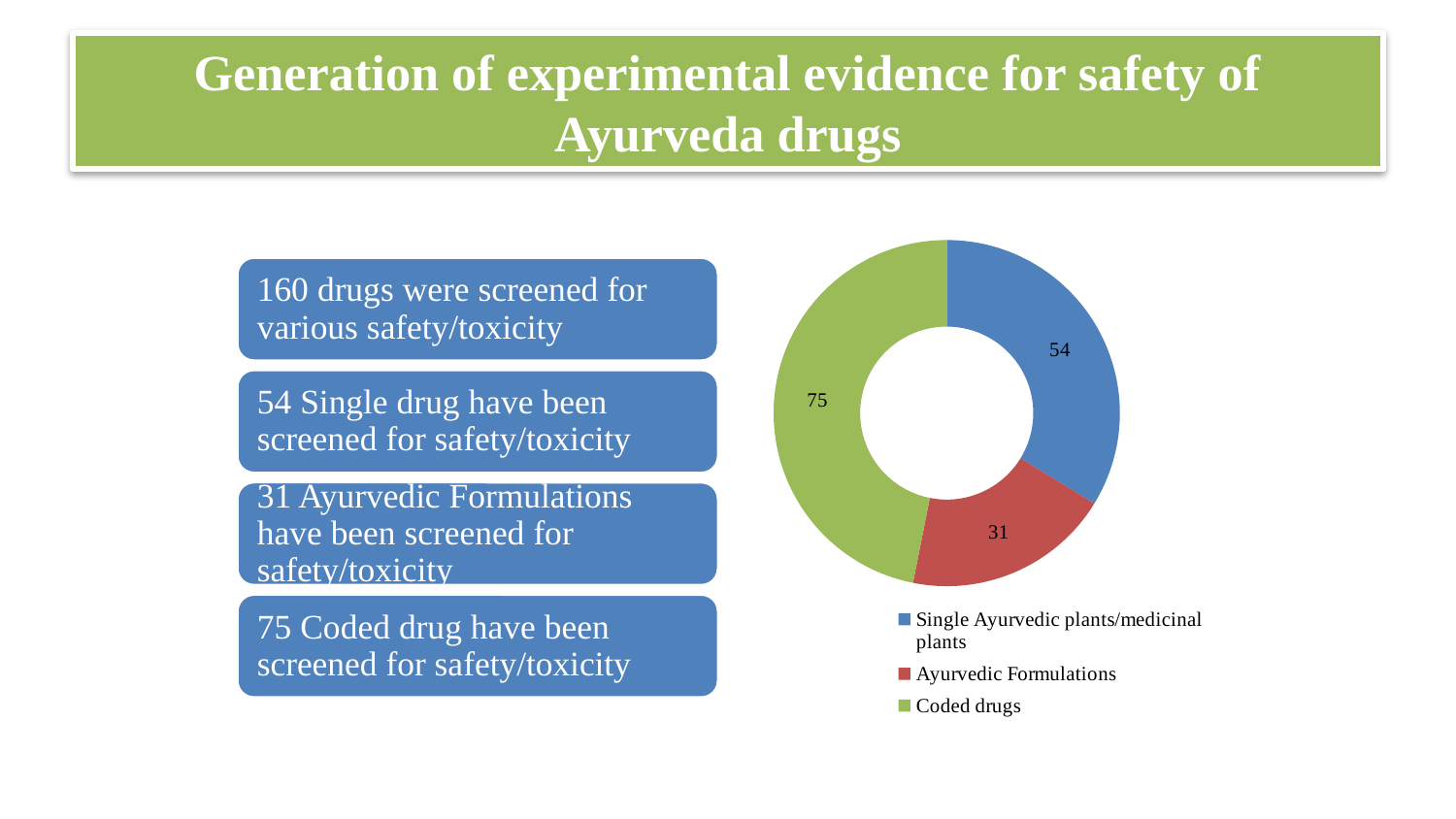
What colour is the Ayurvedic Formulations slice? Red How many categories does the chart show? 3 What is the difference between the values for Coded drugs and Ayurvedic Formulations? 44 What is the value for Single Ayurvedic plants/medicinal plants? 54 Which category has the smallest value? Ayurvedic Formulations What is the value for Coded drugs? 75 Which is larger, the value for Single Ayurvedic plants/medicinal plants or the value for Coded drugs? Coded drugs What is the value for Ayurvedic Formulations? 31 What is the difference between the values for Single Ayurvedic plants/medicinal plants and Ayurvedic Formulations? 23 What is the total of all the values in the chart? 160 Which category has the largest value? Coded drugs What kind of chart is shown on the slide? Doughnut chart